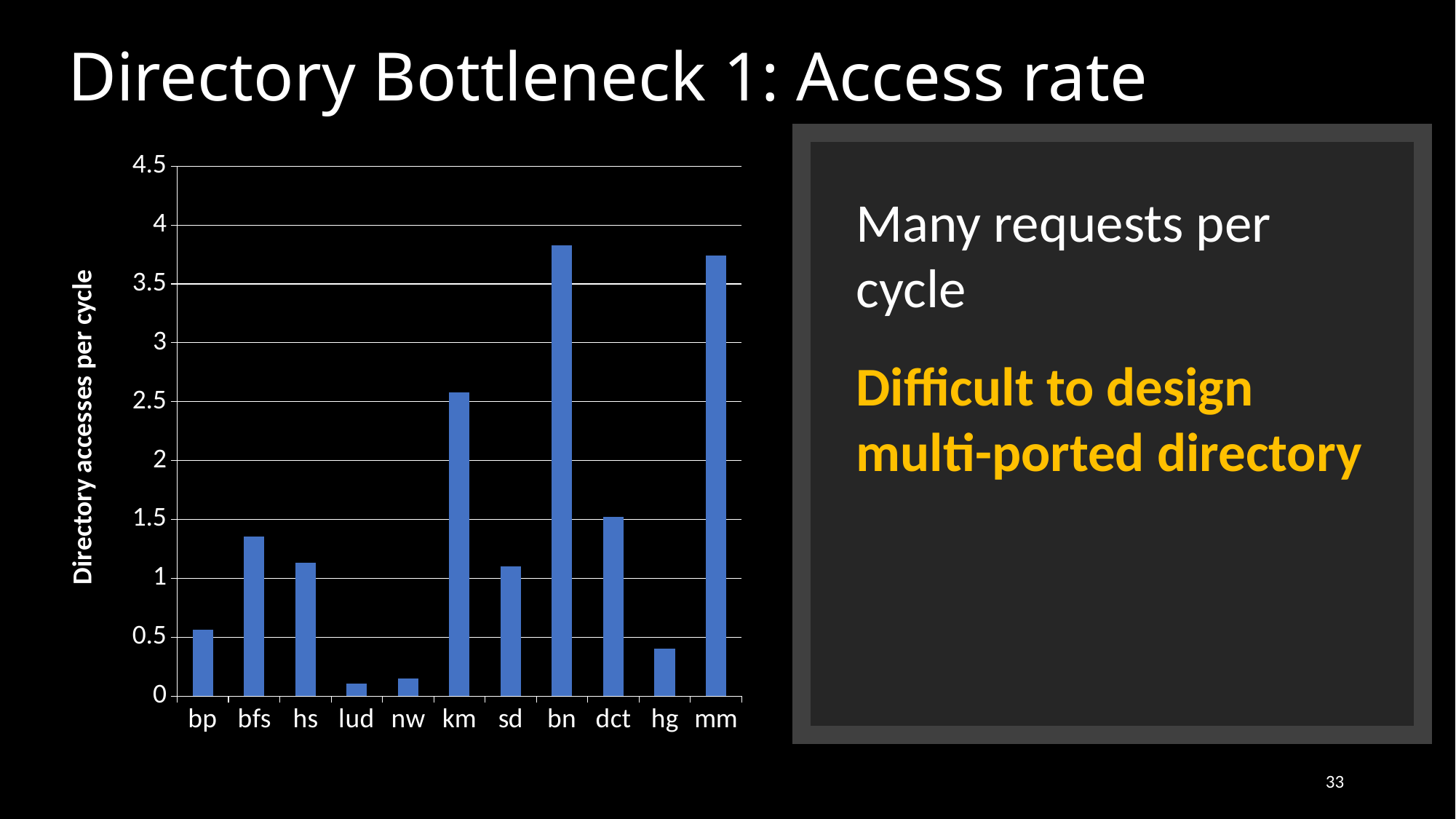
Which has a higher value, bfs or hs? bfs Which has a lower value, lud or hg? lud What is the label of the vertical axis of the chart? Directory accesses per cycle What kind of chart is shown on the slide? bar chart How many categories are shown on the x axis of the chart? 11 Is the value for mm greater or less than 3.5? greater Is the value for hg greater or less than 0.5? less Which has a higher value, km or dct? km Is the value for bfs greater or less than 1? greater